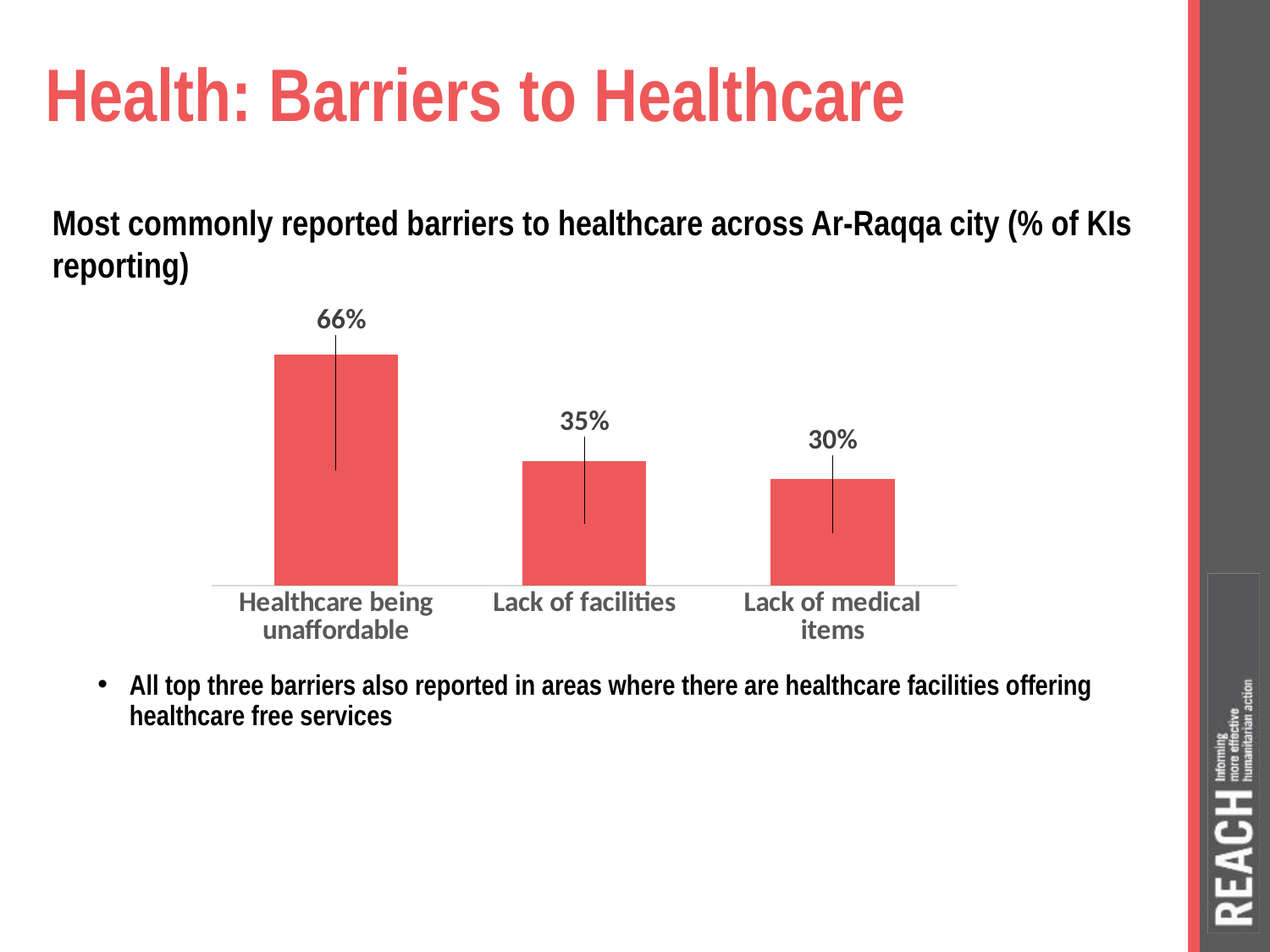
How many barriers to healthcare are shown in the chart? 3 What is the difference in percentage points between healthcare being unaffordable and lack of facilities? 31 Do the values rise or fall from left to right across the chart? Fall What is the difference in percentage points between lack of facilities and lack of medical items? 5 Which barrier to healthcare was reported by the lowest percentage of KIs? Lack of medical items What percentage of KIs reported lack of medical items as a barrier to healthcare? 30% What type of chart is used to show the barriers to healthcare? Bar chart Which was reported by more KIs: lack of facilities or lack of medical items? Lack of facilities Which barrier to healthcare was reported by the highest percentage of KIs? Healthcare being unaffordable What percentage of KIs reported lack of facilities as a barrier to healthcare? 35% What percentage of KIs reported healthcare being unaffordable as a barrier? 66% What colour are the bars in the chart? Red